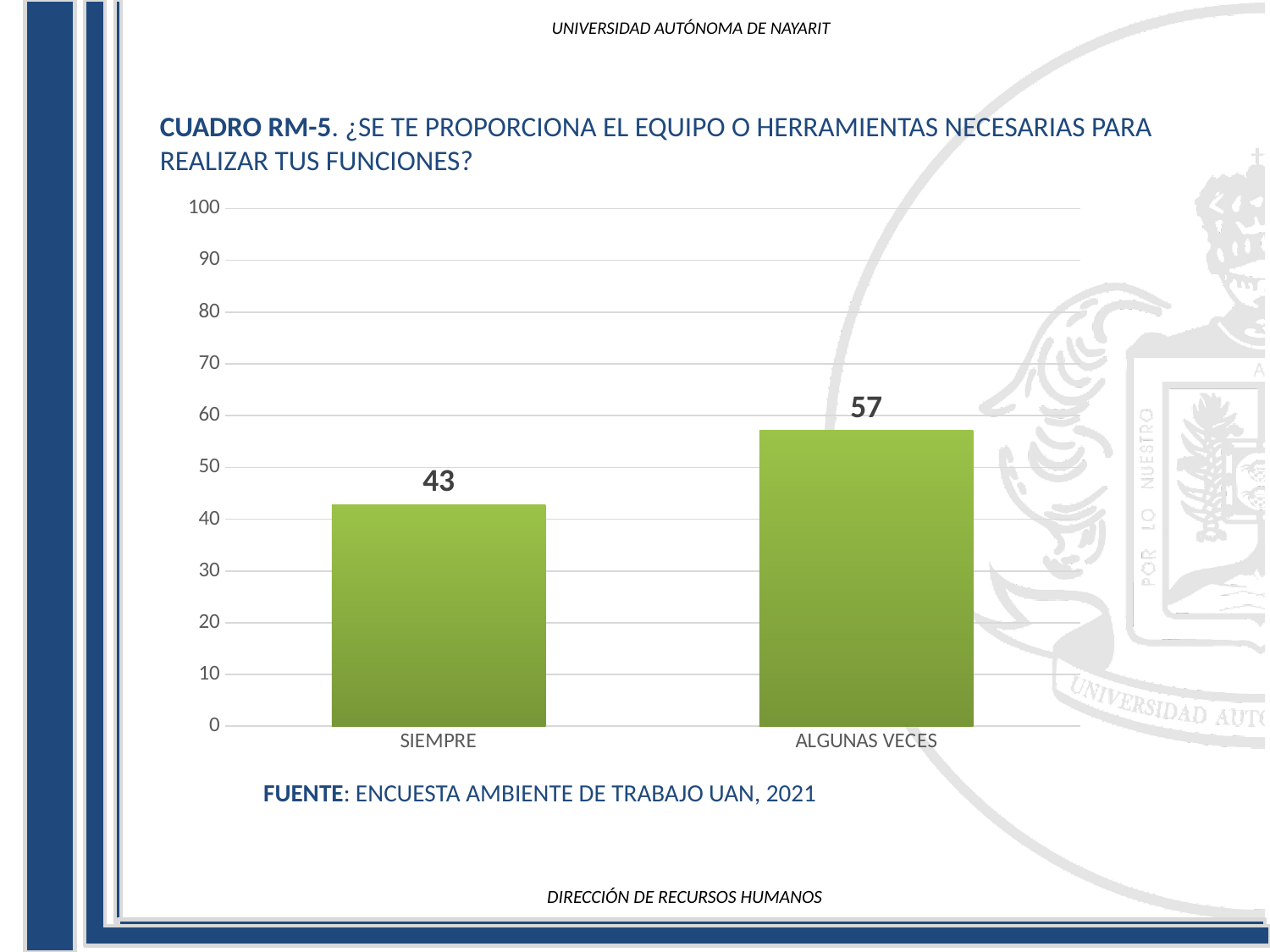
What kind of chart is shown on the slide? bar chart How many categories are shown on the x axis? 2 What is the value for ALGUNAS VECES? 57 What is the source cited below the chart? ENCUESTA AMBIENTE DE TRABAJO UAN, 2021 Which is larger, the value for SIEMPRE or the value for ALGUNAS VECES? ALGUNAS VECES What is the total of the two values shown in the chart? 100 What is the difference between the values for ALGUNAS VECES and SIEMPRE? 14 Is the value for ALGUNAS VECES greater or less than 50? greater Is the value for SIEMPRE greater or less than 50? less Which category has the lowest value? SIEMPRE What is the value for SIEMPRE? 43 Which category has the highest value? ALGUNAS VECES